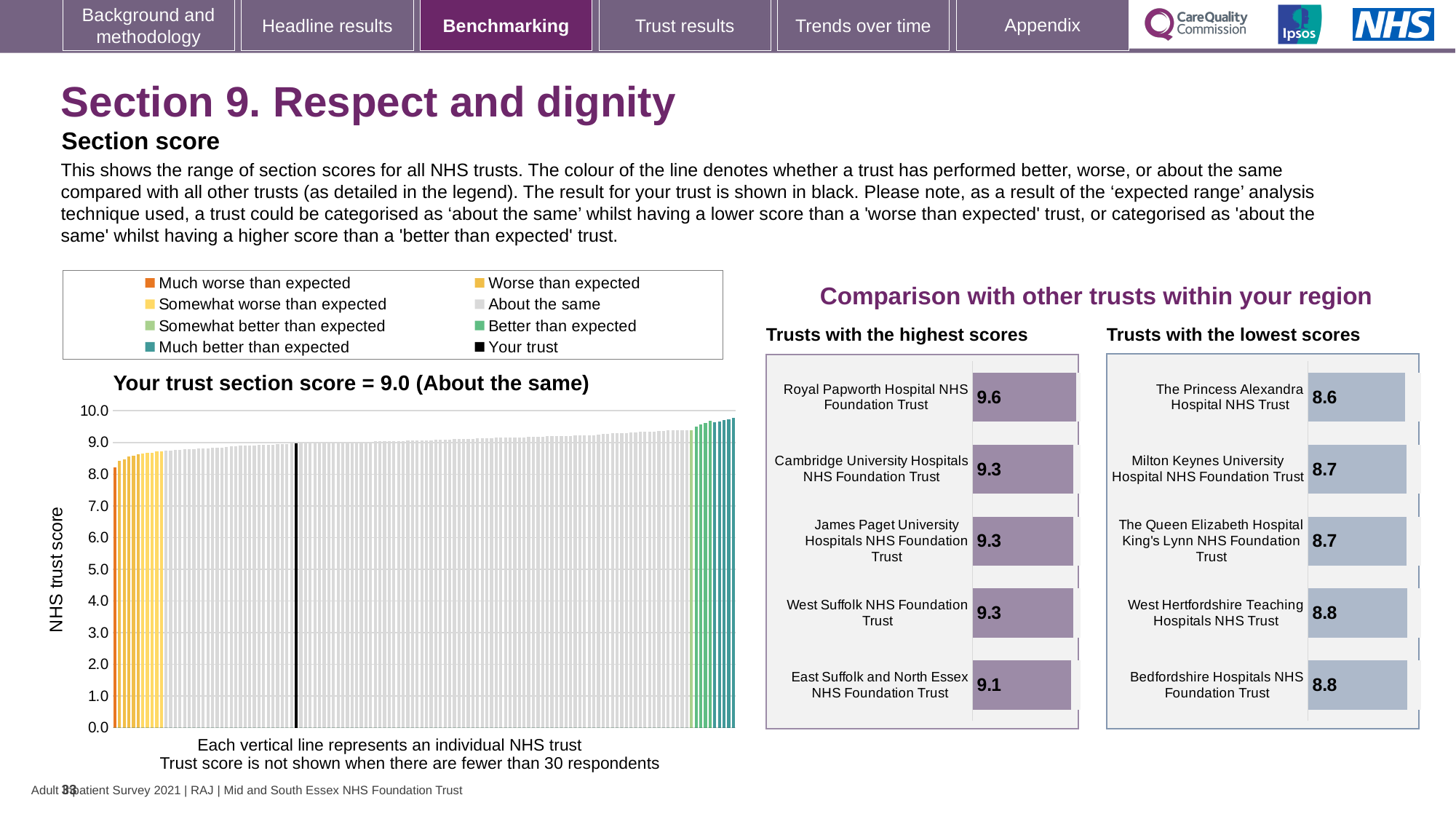
In the 'Your trust section score' chart, what category is your trust placed in? About the same In the 'Trusts with the lowest scores' chart, what is the score for Bedfordshire Hospitals NHS Foundation Trust? 8.8 In the 'Your trust section score' chart, what is the section score for your trust? 9.0 In the 'Trusts with the lowest scores' chart, which trust has the lowest score? The Princess Alexandra Hospital NHS Trust What kind of chart is the 'Your trust section score' chart? bar chart How many entries does the legend above the 'Your trust section score' chart list? 8 In the 'Trusts with the highest scores' chart, what is the score for Royal Papworth Hospital NHS Foundation Trust? 9.6 In the 'Trusts with the highest scores' chart, which trust has the lowest score? East Suffolk and North Essex NHS Foundation Trust In the 'Trusts with the highest scores' chart, how many trusts are shown? 5 In the 'Trusts with the highest scores' chart, what is the difference between the scores of Royal Papworth Hospital NHS Foundation Trust and East Suffolk and North Essex NHS Foundation Trust? 0.5 What is the y-axis label of the 'Your trust section score' chart? NHS trust score In the 'Trusts with the lowest scores' chart, which has the higher score: Milton Keynes University Hospital NHS Foundation Trust or West Hertfordshire Teaching Hospitals NHS Trust? West Hertfordshire Teaching Hospitals NHS Trust